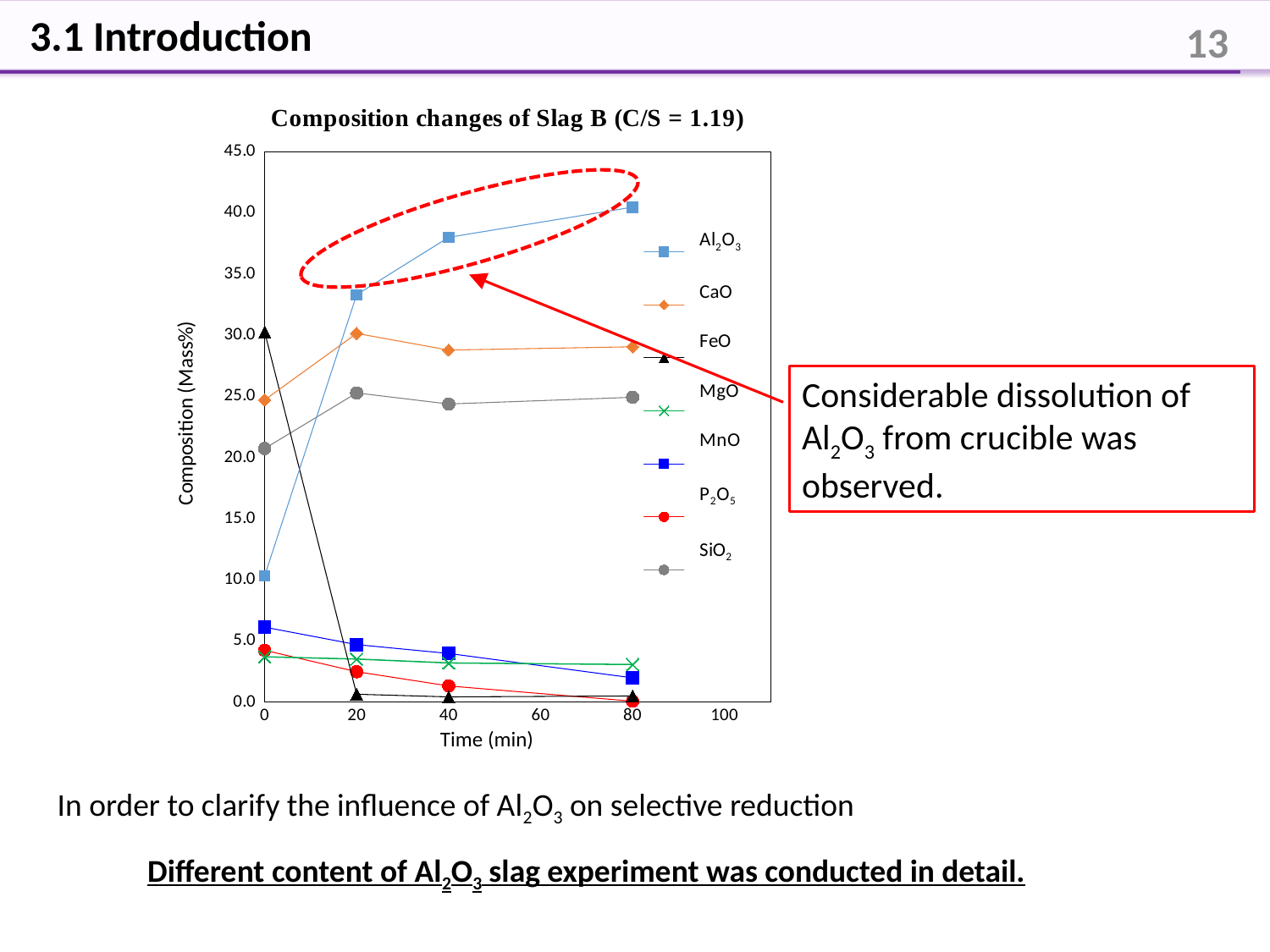
Does the FeO series rise or fall as time increases from 0 to 80 min? Fall Does the Al2O3 series rise or fall as time increases from 0 to 80 min? Rise What is the label of the y axis? Composition (Mass%) What kind of chart is shown on the slide? Line chart At 80 min, which is larger: CaO or SiO2? CaO How many series does the chart legend list? 7 Is the value for FeO at 20 min greater or less than 5.0? less Which series has the highest composition at 0 min? FeO What is the title of the chart? Composition changes of Slag B (C/S = 1.19) Which series has the highest composition at 80 min? Al2O3 How many time points are plotted for each series? 4 Is the value for Al2O3 at 40 min greater or less than 35.0? greater